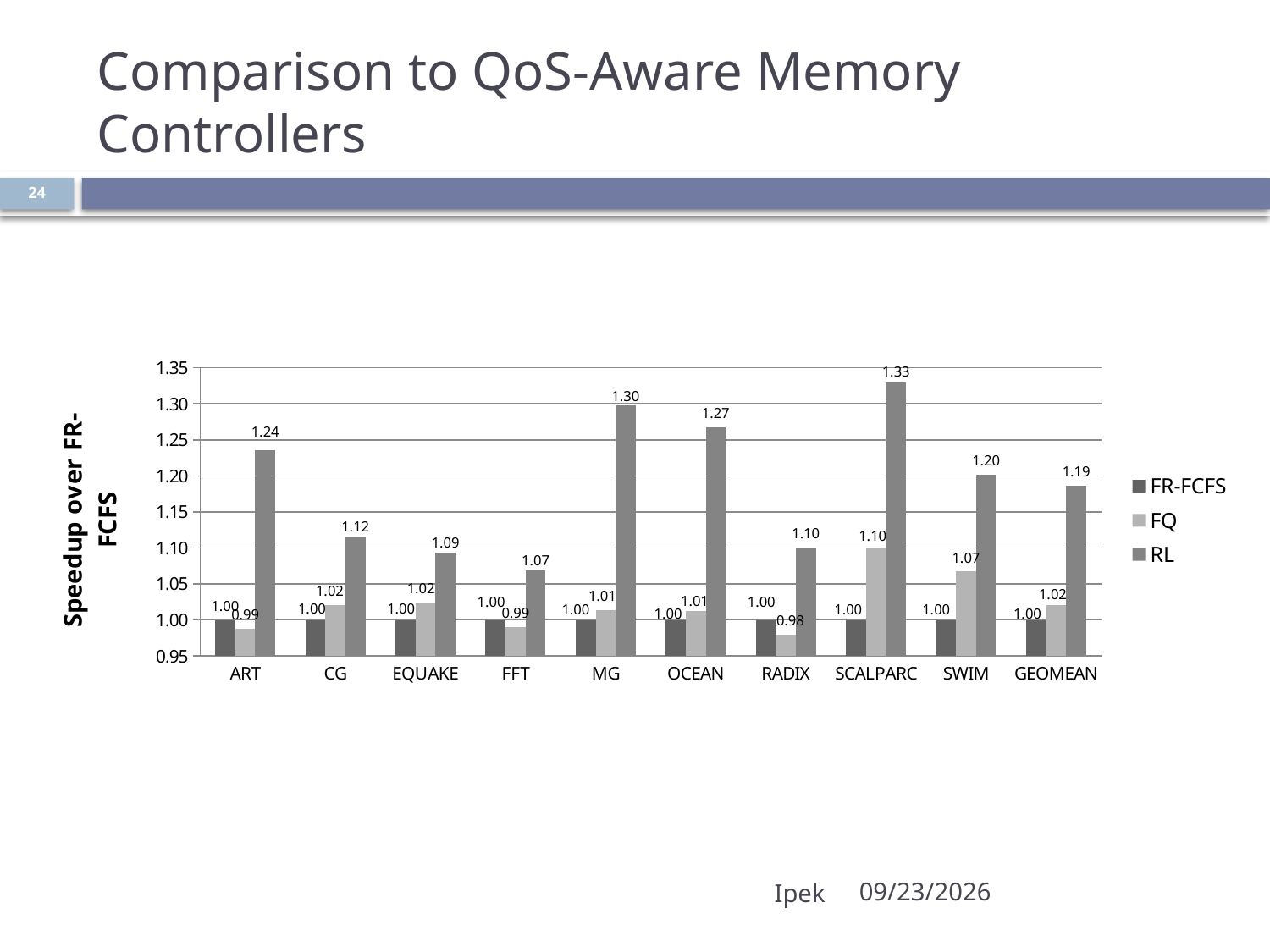
What is the FQ speedup for SWIM? 1.07 How many series does the legend list? 3 Which benchmark has the highest RL speedup? SCALPARC What is the RL speedup for SCALPARC? 1.33 What kind of chart is shown on the slide? Bar chart What is the label of the y axis? Speedup over FR-FCFS How many benchmark categories are shown on the x axis? 10 What is the RL speedup for GEOMEAN? 1.19 What is the FQ speedup for RADIX? 0.98 What is the difference between the RL and FQ speedups for MG? 0.29 Which benchmark has the lowest FQ speedup? RADIX Which is larger, the RL speedup for ART or the RL speedup for CG? ART